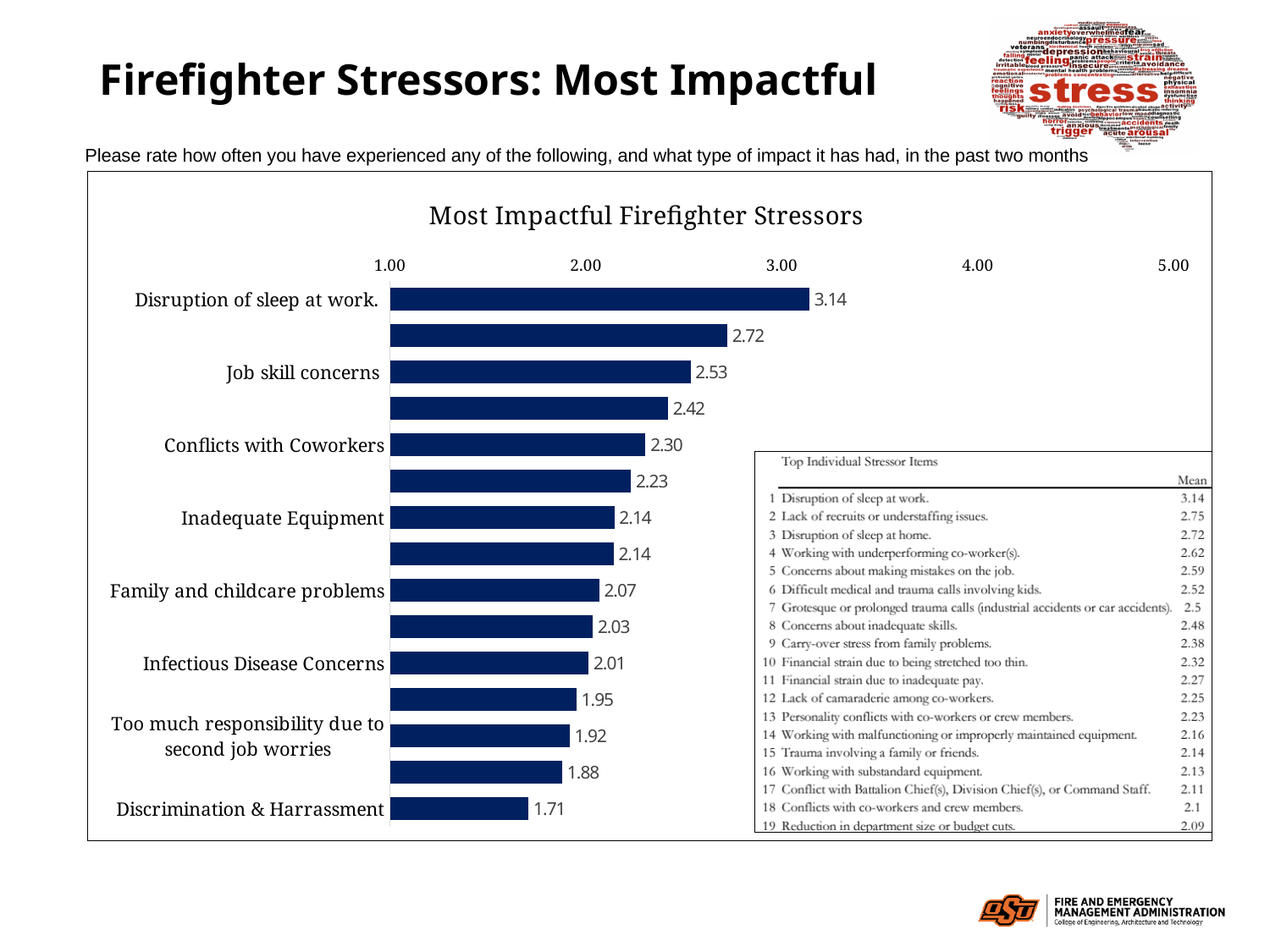
Which stressor has the lowest value in the chart? Discrimination & Harrassment Which has a larger value, Inadequate Equipment or Family and childcare problems? Inadequate Equipment What is the value for Discrimination & Harrassment? 1.71 What is the title of the chart? Most Impactful Firefighter Stressors What is the value for Conflicts with Coworkers? 2.30 Is the value for Disruption of sleep at work greater or less than 3.00? greater Which stressor has the highest value in the chart? Disruption of sleep at work. What is the difference between the values for Disruption of sleep at work and Discrimination & Harrassment? 1.43 How many bars are plotted in the chart? 15 What is the value for Job skill concerns? 2.53 What is the value for Disruption of sleep at work in the Most Impactful Firefighter Stressors chart? 3.14 What kind of chart is shown on the slide? Bar chart